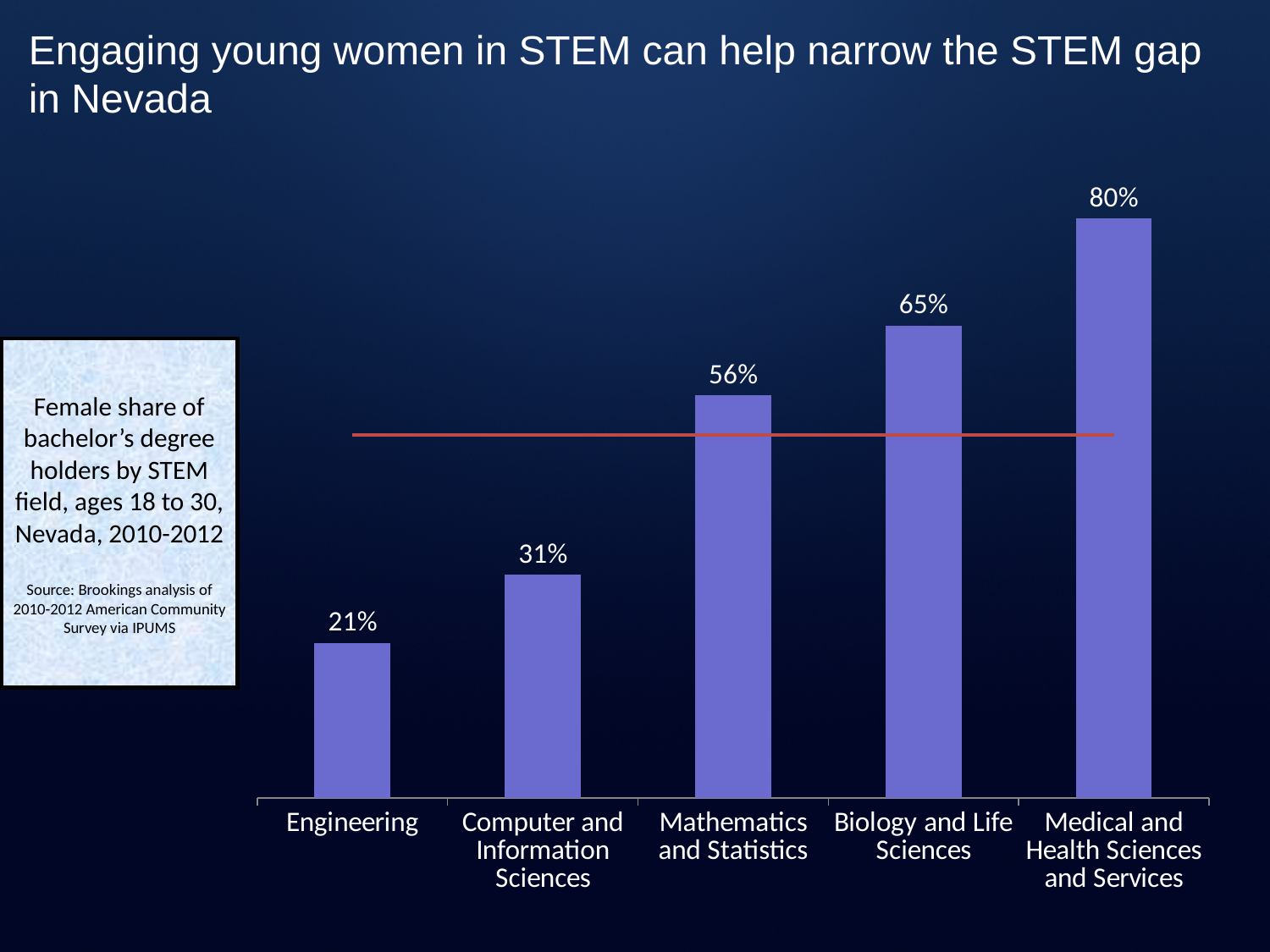
What is the female share of bachelor's degree holders in Engineering? 21% What is the difference in female share between Medical and Health Sciences and Services and Engineering? 59 percentage points What type of chart is shown on the slide? Bar chart What is the female share of bachelor's degree holders in Computer and Information Sciences? 31% What is the female share of bachelor's degree holders in Biology and Life Sciences? 65% Which STEM field has the lowest female share of bachelor's degree holders? Engineering Which has a larger female share: Computer and Information Sciences or Mathematics and Statistics? Mathematics and Statistics What is the female share of bachelor's degree holders in Medical and Health Sciences and Services? 80% Which STEM field has the highest female share of bachelor's degree holders? Medical and Health Sciences and Services How many STEM fields are shown in the chart? 5 What is the female share of bachelor's degree holders in Mathematics and Statistics? 56% What is the difference in female share between Biology and Life Sciences and Mathematics and Statistics? 9 percentage points